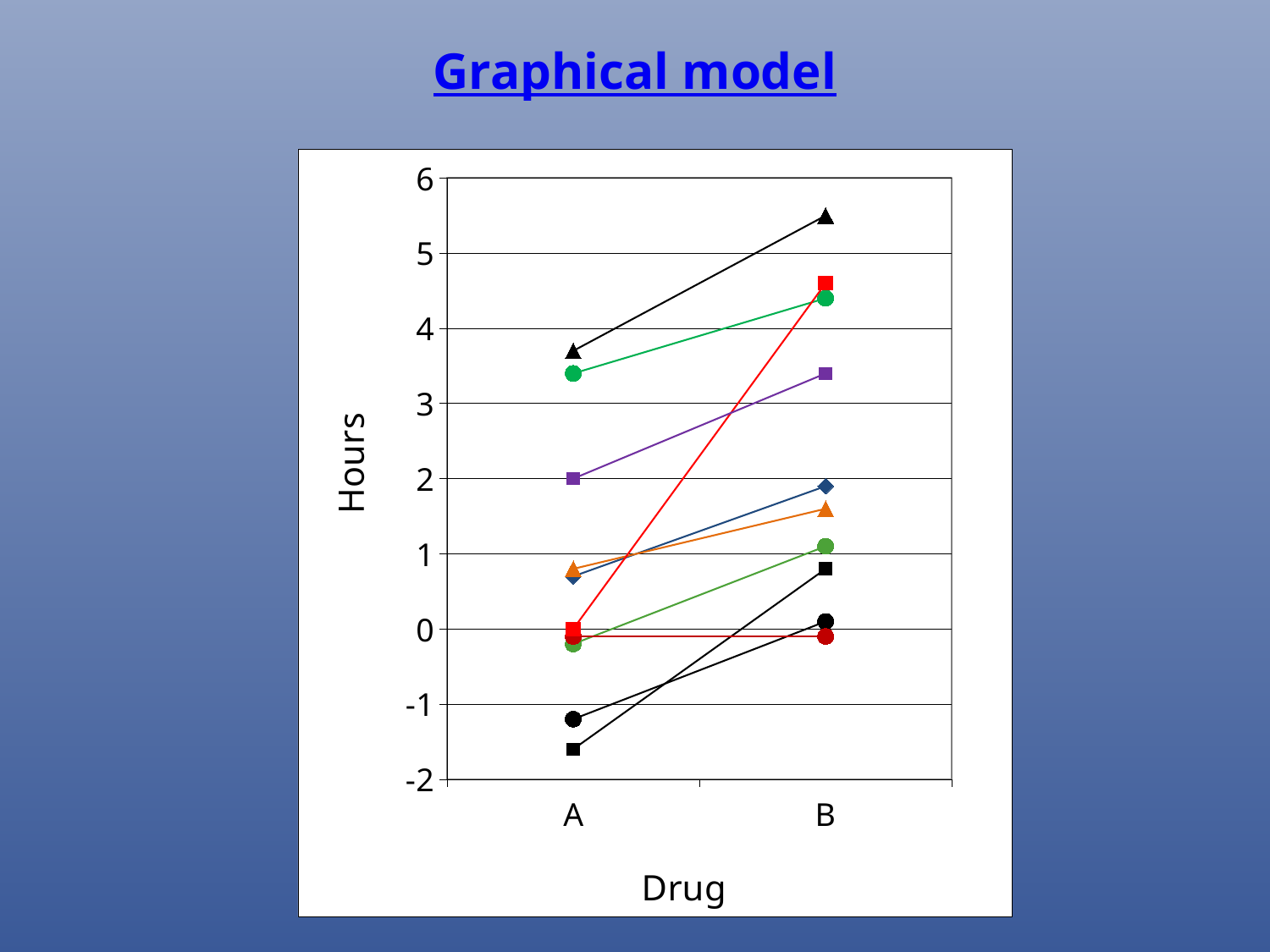
Do the lines in the chart generally rise or fall from Drug A to Drug B? rise Is the value of the black triangle series for Drug A greater or less than 3? greater What is the title of the y axis of the chart? Hours Under which drug, A or B, does the highest plotted point in the chart occur? B How many categories are shown on the x axis of the chart? 2 Under which drug, A or B, does the lowest plotted point in the chart occur? A Is the value of the black triangle series for Drug B greater or less than 5? greater Is the value of the black square series for Drug A greater or less than -1? less What kind of chart is shown on the slide? line chart What is the title of the x axis of the chart? Drug